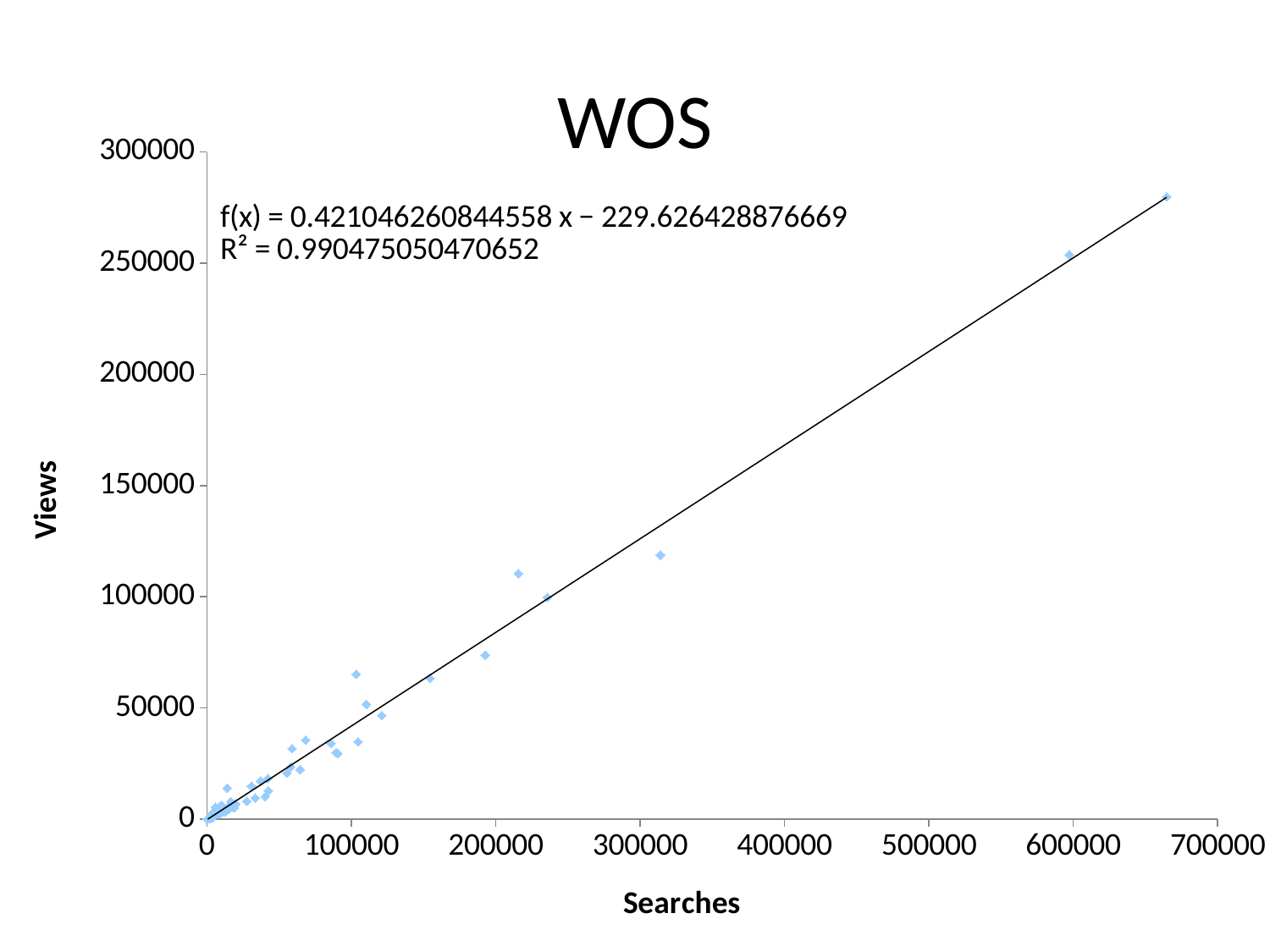
Is the Views value for the point at about 315000 Searches greater or less than 150000? less What are the labels of the x axis and the y axis of the chart? Searches (x axis) and Views (y axis) Do the Views values rise or fall as Searches increase along the x axis? Rise Is the Searches value for the rightmost point greater or less than 600000? greater What kind of chart is shown on the slide? Scatter chart What is the full equation of the fitted line printed on the chart? f(x) = 0.421046260844558 x − 229.626428876669 Is the R² value of the fitted line greater or less than 0.95? greater What is the R² value printed on the chart? 0.990475050470652 What is the title of the chart? WOS What is the slope of the fitted line f(x) printed on the chart? 0.421046260844558 What is the intercept of the fitted line f(x) printed on the chart? −229.626428876669